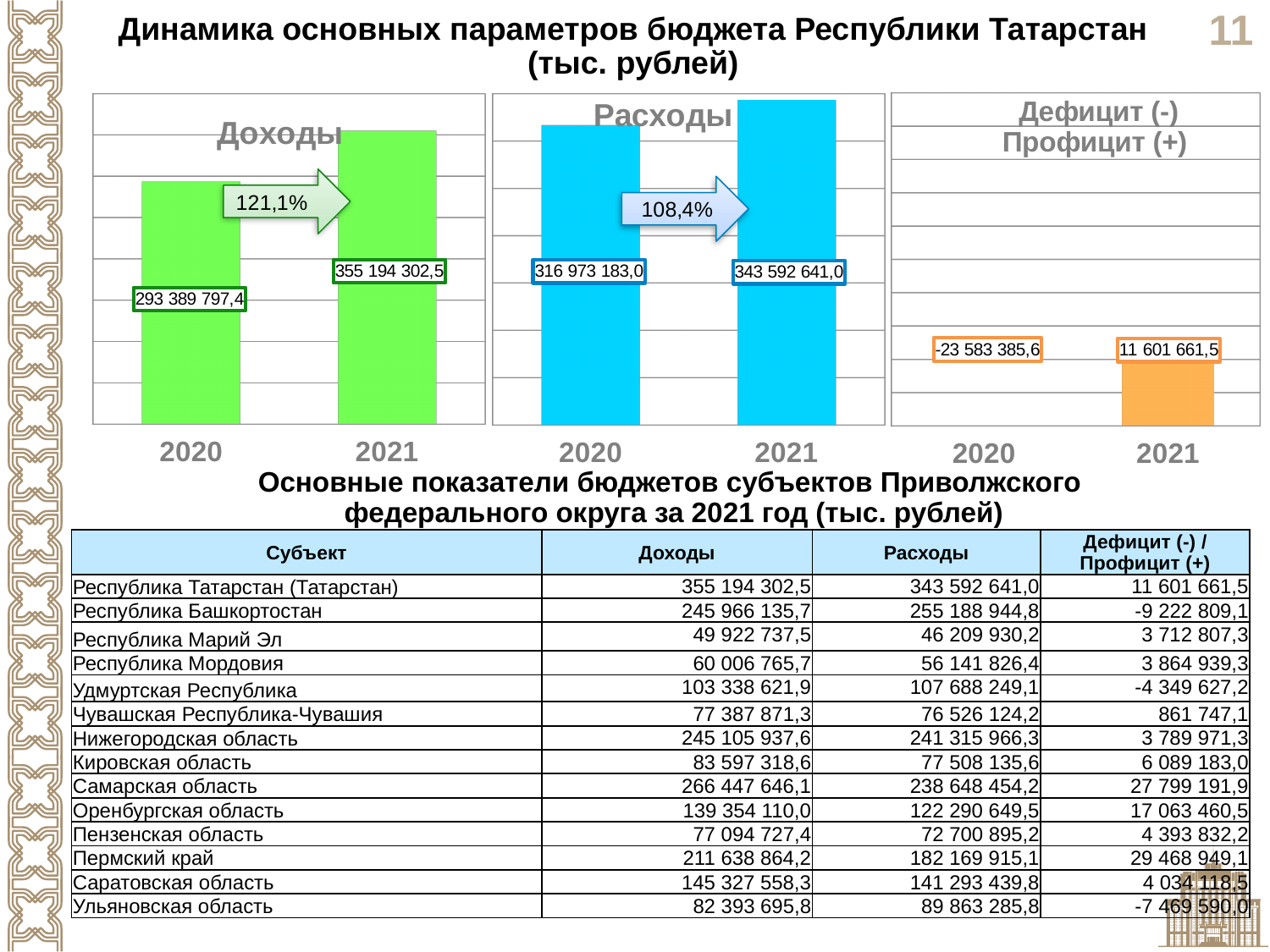
What kind of chart is the Доходы chart? bar chart In the Дефицит (-) Профицит (+) chart, what is the value for 2021? 11 601 661,5 In the Расходы chart, what is the difference between the 2021 and 2020 values? 26 619 458,0 In the Доходы chart, by how much does the 2021 value exceed the 2020 value? 61 804 505,1 In the Доходы chart, what is the value for 2020? 293 389 797,4 In the Доходы chart, what is the value for 2021? 355 194 302,5 How many years are shown on the x axis of the Расходы chart? 2 In the Расходы chart, what is the value for 2020? 316 973 183,0 In the Расходы chart, what is the value for 2021? 343 592 641,0 In the Расходы chart, which year has the higher value, 2020 or 2021? 2021 In the Дефицит (-) Профицит (+) chart, what is the value for 2020? -23 583 385,6 What percentage is shown on the arrow in the Доходы chart? 121,1%